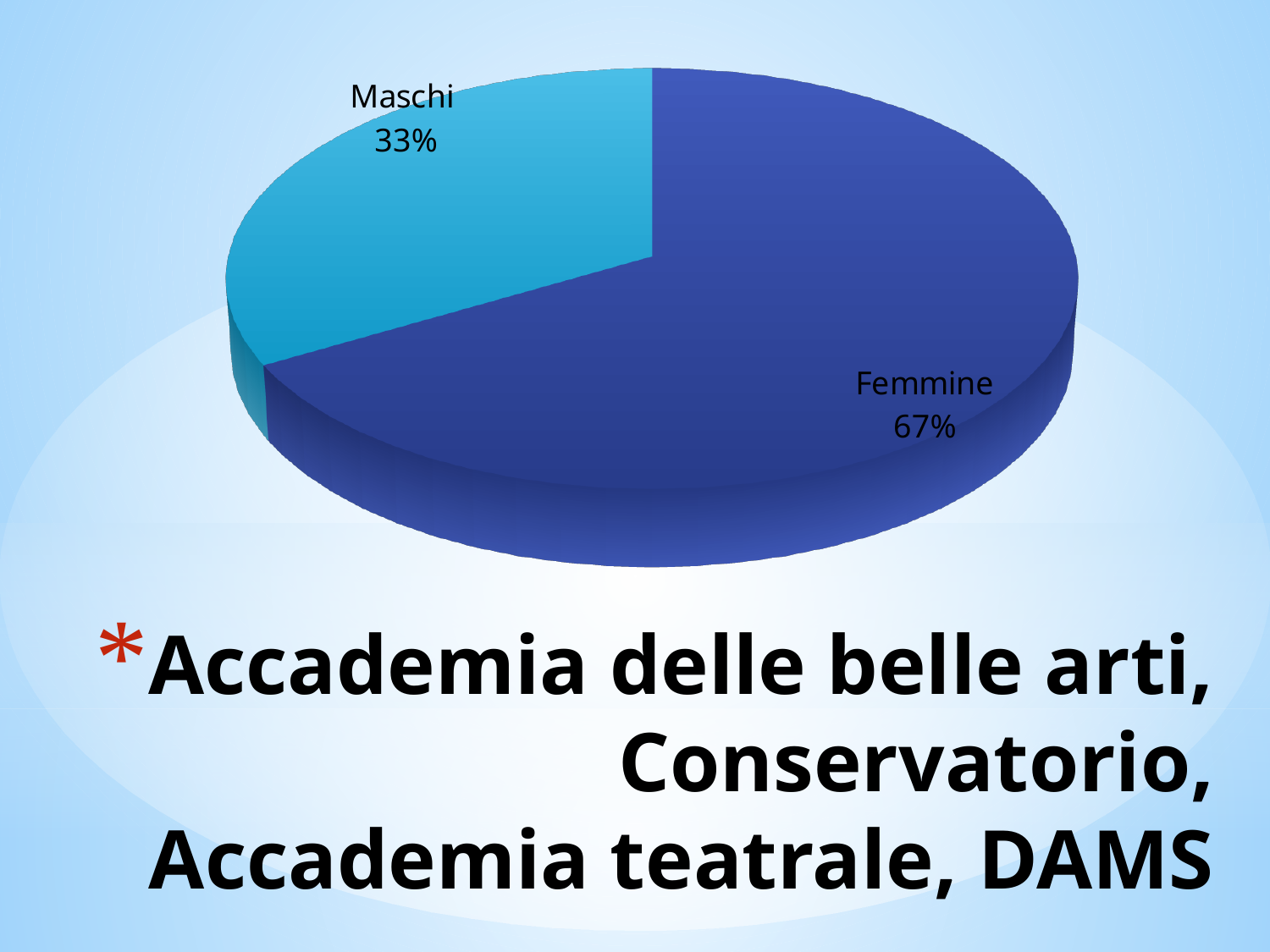
How many slices does the pie chart have? 2 What colour is the Femmine slice of the pie? dark blue What kind of chart is shown on the slide? pie chart Which slice of the pie is the smallest? Maschi What share of the pie does the Maschi slice represent? 33% Which slice of the pie is the largest? Femmine What is the difference in percentage points between the Femmine and Maschi slices? 34 Which slice is larger, Maschi or Femmine? Femmine What colour is the Maschi slice of the pie? light blue What percentage of the pie is labelled Femmine? 67% What percentage of the pie is labelled Maschi? 33%